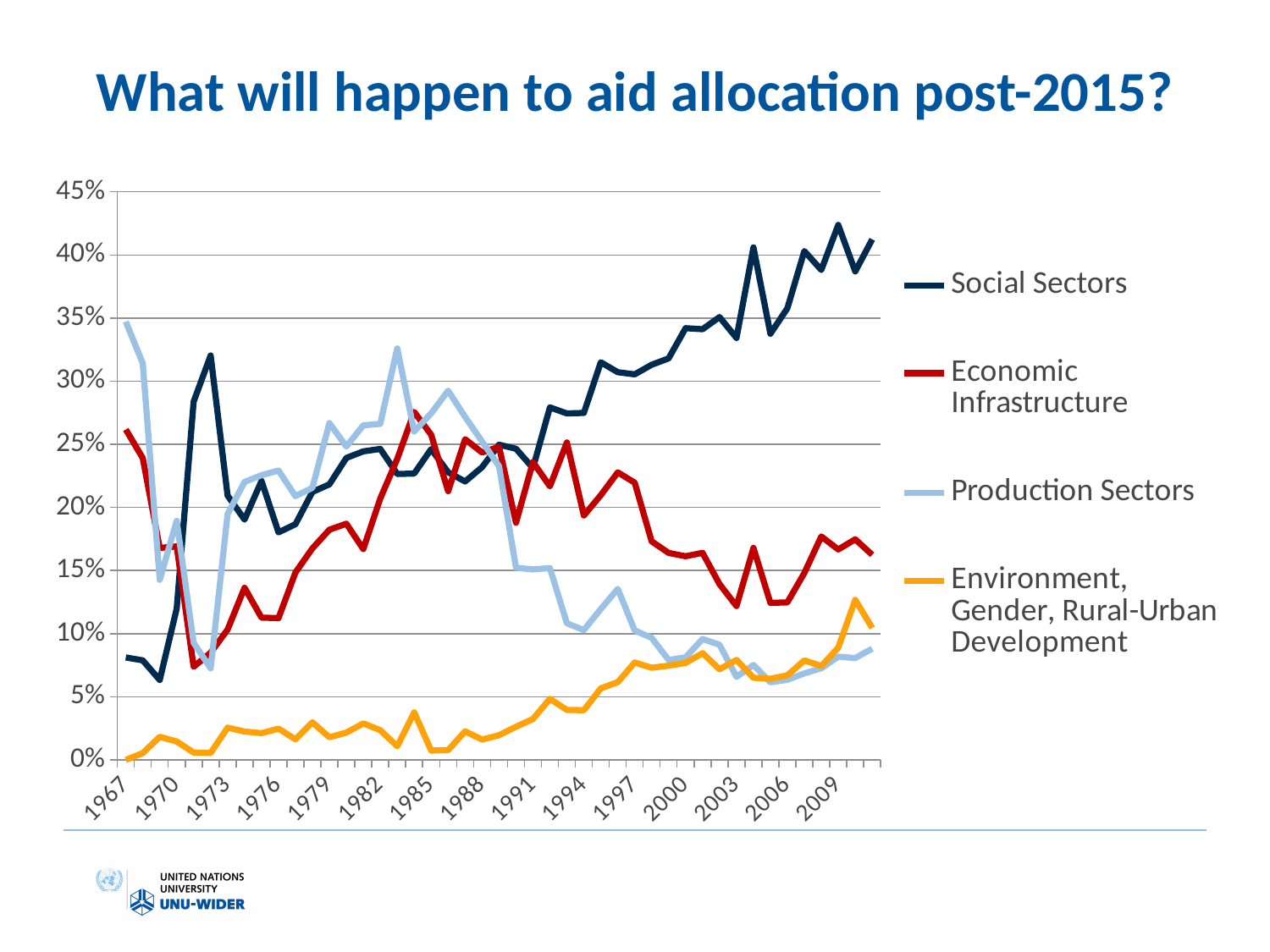
How many series does the legend list? 4 Is the value for Social Sectors in 2009 greater or less than 35%? greater In 2009, which is larger: Social Sectors or Economic Infrastructure? Social Sectors Which series has the lowest value in 1967? Environment, Gender, Rural-Urban Development Is the value for Environment, Gender, Rural-Urban Development in 1967 greater or less than 5%? less Is the value for Production Sectors in 1967 greater or less than 30%? greater What are the series names listed in the legend? Social Sectors; Economic Infrastructure; Production Sectors; Environment, Gender, Rural-Urban Development What is the title of the slide? What will happen to aid allocation post-2015? Does the Social Sectors line generally rise or fall from 1991 to the end of the period? rise Does the Production Sectors line generally rise or fall from 1988 to 2009? fall What kind of chart is shown on the slide? line chart